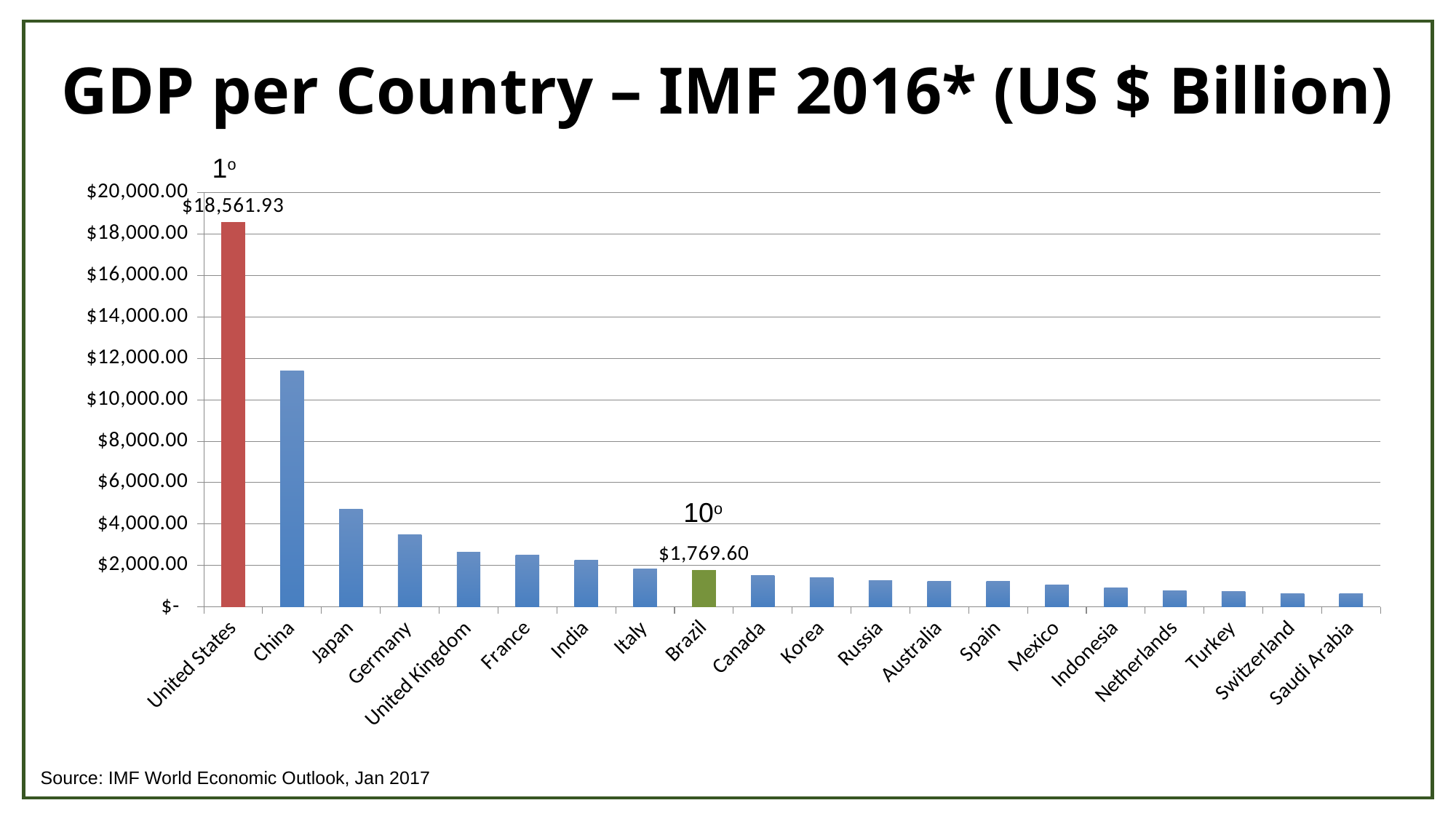
Is the value for Saudi Arabia greater or less than $2,000.00? less What is the GDP value shown for the United States? $18,561.93 What colour is the bar for Brazil? Green Is the value for China greater or less than $10,000.00? greater Is the value for Germany greater or less than $4,000.00? less How many countries are shown in the chart? 20 Which has a larger GDP, China or Japan? China What kind of chart is shown on the slide? Bar chart What is the GDP value shown for Brazil? $1,769.60 What is the difference between the GDP of the United States and Brazil? $16,792.33 Do the values rise or fall from left to right along the x axis? Fall Which country has the highest GDP in the chart? United States